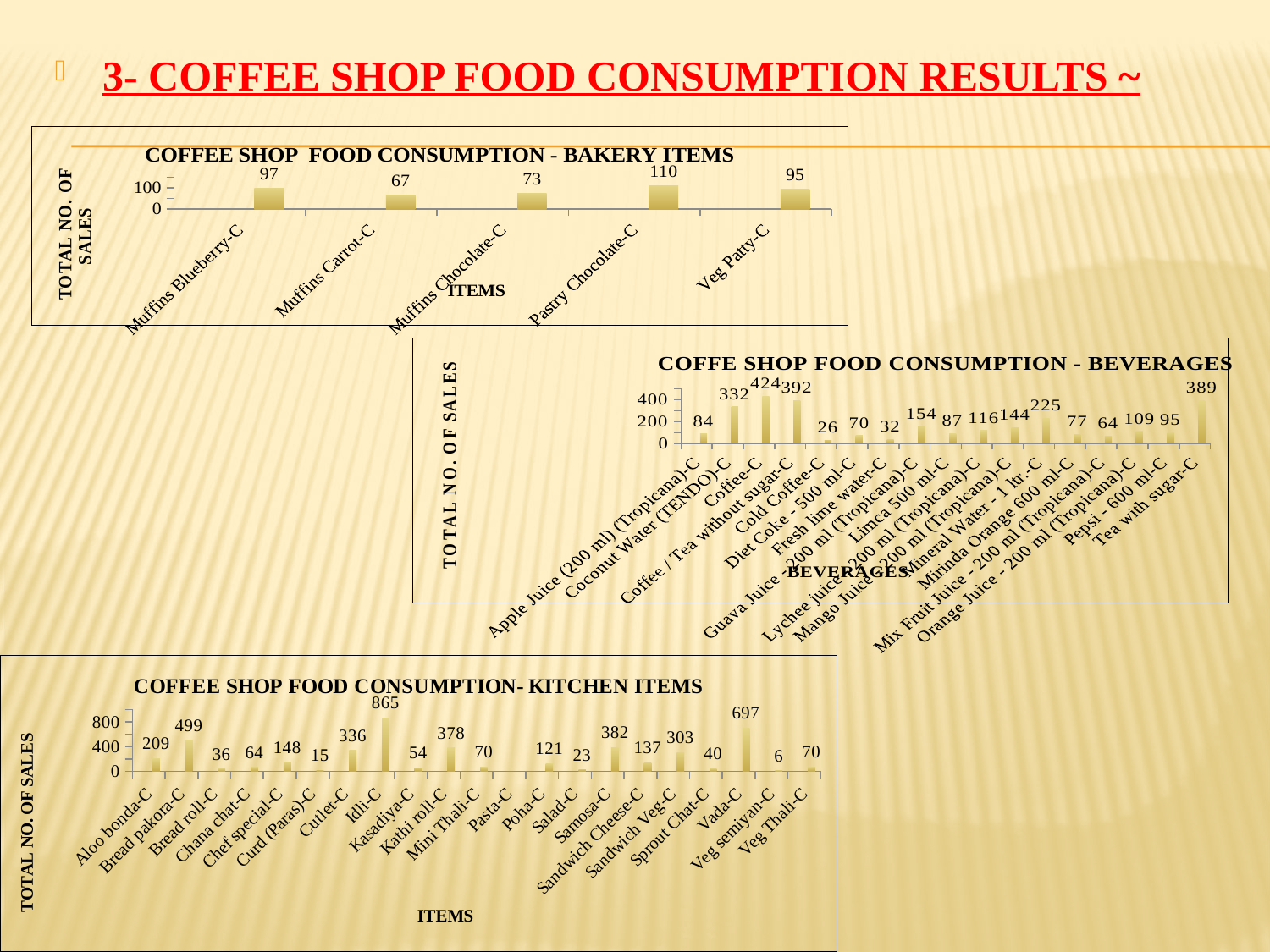
In the Beverages chart, which beverage has the lowest total number of sales? Cold Coffee-C In the Beverages chart, what is the value for Tea with sugar-C? 389 How many items are shown in the Bakery Items chart? 5 In the Bakery Items chart, what is the difference between Muffins Blueberry-C and Muffins Chocolate-C? 24 In the Bakery Items chart, which item has the lowest total number of sales? Muffins Carrot-C In the Beverages chart, which beverage has the highest total number of sales? Coffee-C In the Kitchen Items chart, what is the highest value shown? 865 In the Bakery Items chart, what is the value for Pastry Chocolate-C? 110 In the Beverages chart, which is larger: Mineral Water - 1 ltr.-C or Guava Juice - 200 ml (Tropicana)-C? Mineral Water - 1 ltr.-C What type of chart is the Beverages chart? Bar chart In the Kitchen Items chart, what is the difference between Kathi roll-C and Cutlet-C? 42 In the Kitchen Items chart, what is the value for Bread pakora-C? 499